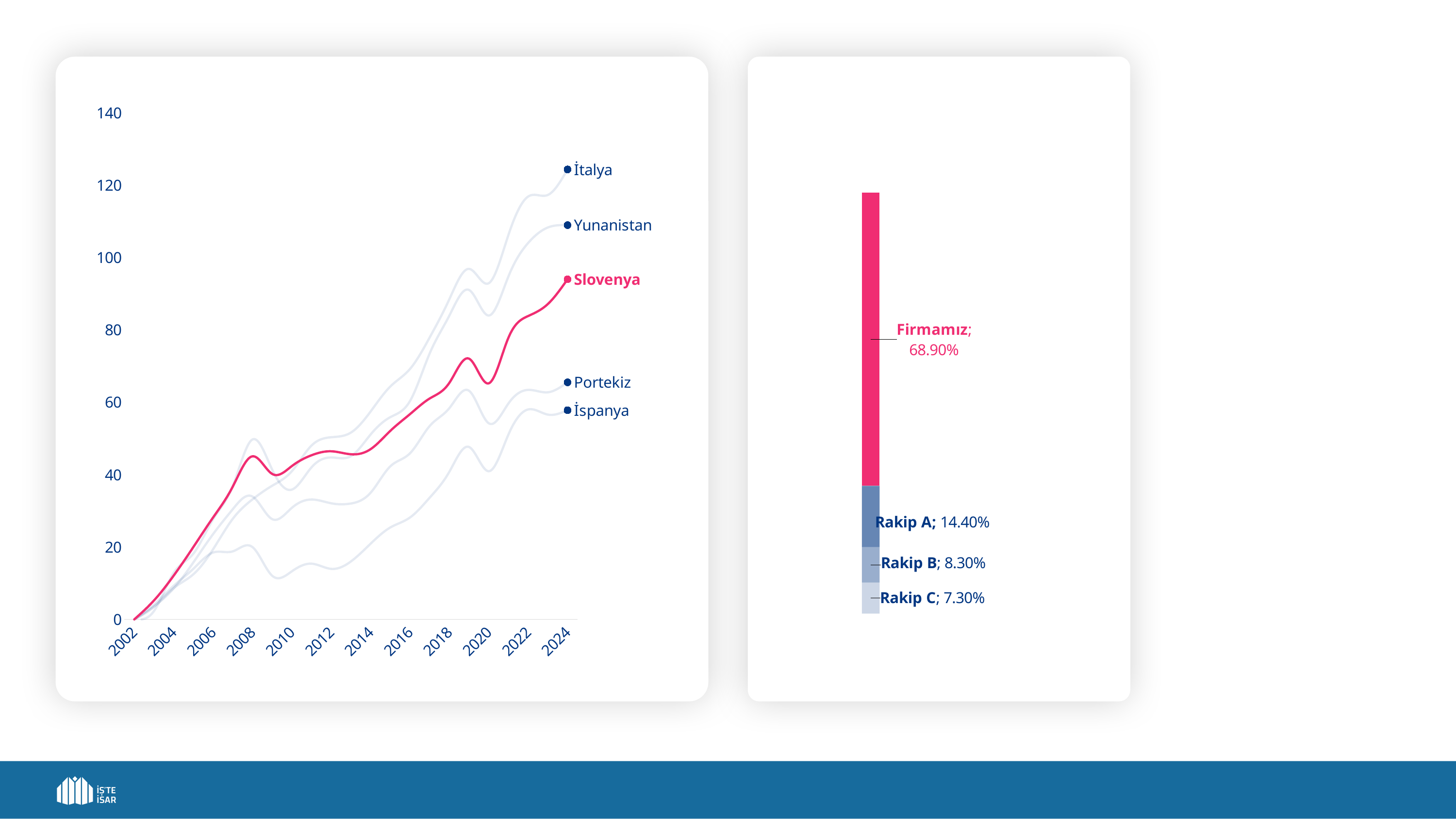
On the right chart, what is the difference between Rakip A and Rakip B? 6.10% On the right chart, what is the total of all four segments of the stacked bar? 98.90% On the left chart, how many countries (series) are plotted? 5 On the right chart, what is the value for Rakip C? 7.30% On the right chart, which segment has the smallest value? Rakip C On the right chart, what is the value for Firmamız? 68.90% On the left chart, which series is highlighted in pink? Slovenya On the right chart, what is the value for Rakip A? 14.40% On the left chart, is the value for Slovenya in 2024 greater or less than 80? greater What kind of chart is the right chart? Bar chart On the left chart, which country has the highest value in 2024? İtalya What kind of chart is the left chart? Line chart